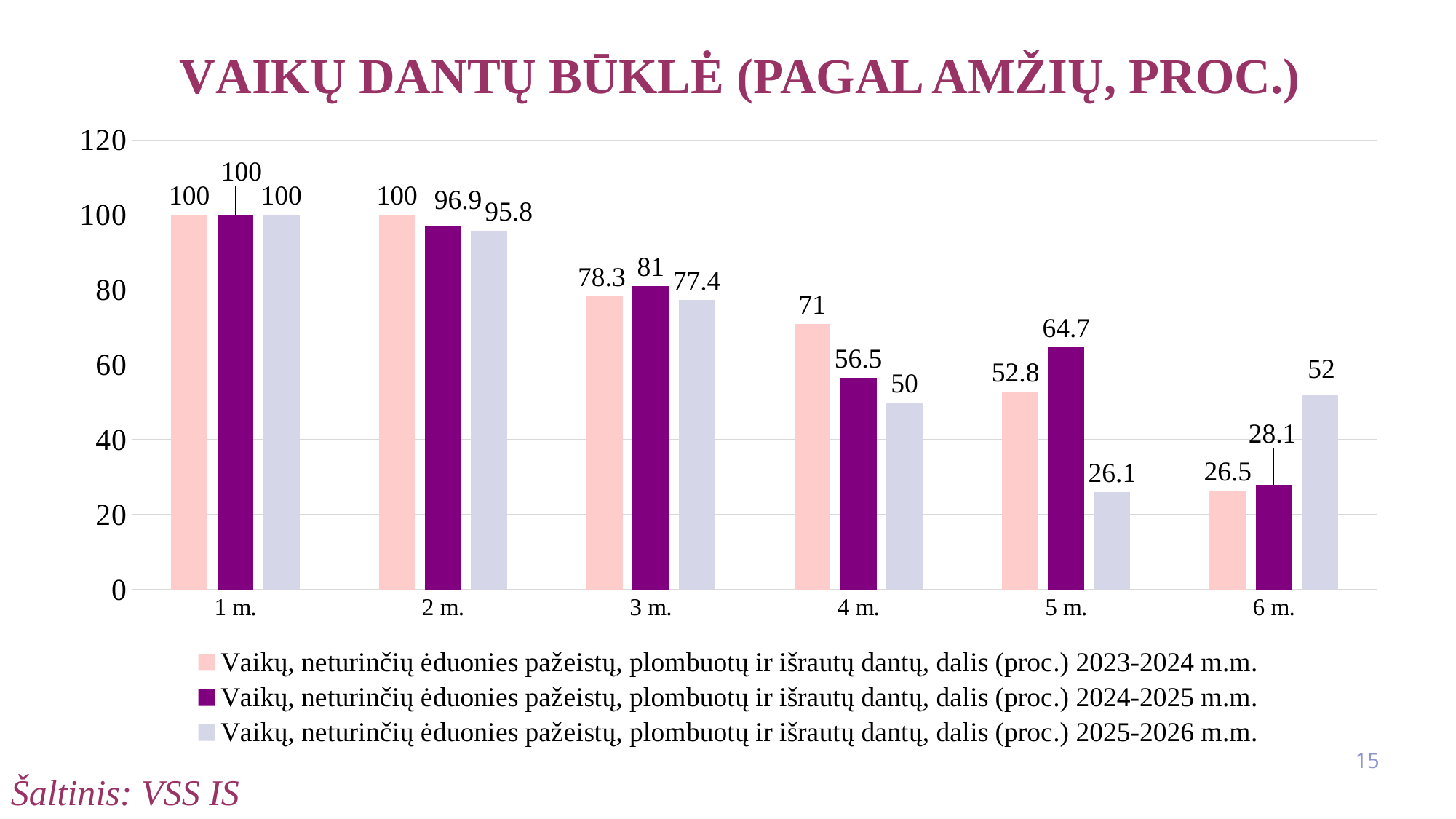
How many series does the legend list? 3 Do the values in the 2023-2024 m.m. series rise or fall from 1 m. to 6 m.? fall What is the value for 2 m. in the 2024-2025 m.m. series? 96.9 What is the value for 4 m. in the 2023-2024 m.m. series? 71 How many age categories are shown on the x axis? 6 What type of chart is shown on the slide? bar chart What is the difference between the 2024-2025 m.m. and 2025-2026 m.m. values for 5 m.? 38.6 What is the title of the chart? VAIKŲ DANTŲ BŪKLĖ (PAGAL AMŽIŲ, PROC.) For 6 m., which series has the larger value: 2023-2024 m.m. or 2025-2026 m.m.? 2025-2026 m.m. Which age category has the highest value in the 2025-2026 m.m. series? 1 m. What is the value for 5 m. in the 2025-2026 m.m. series? 26.1 Which age category has the lowest value in the 2023-2024 m.m. series? 6 m.